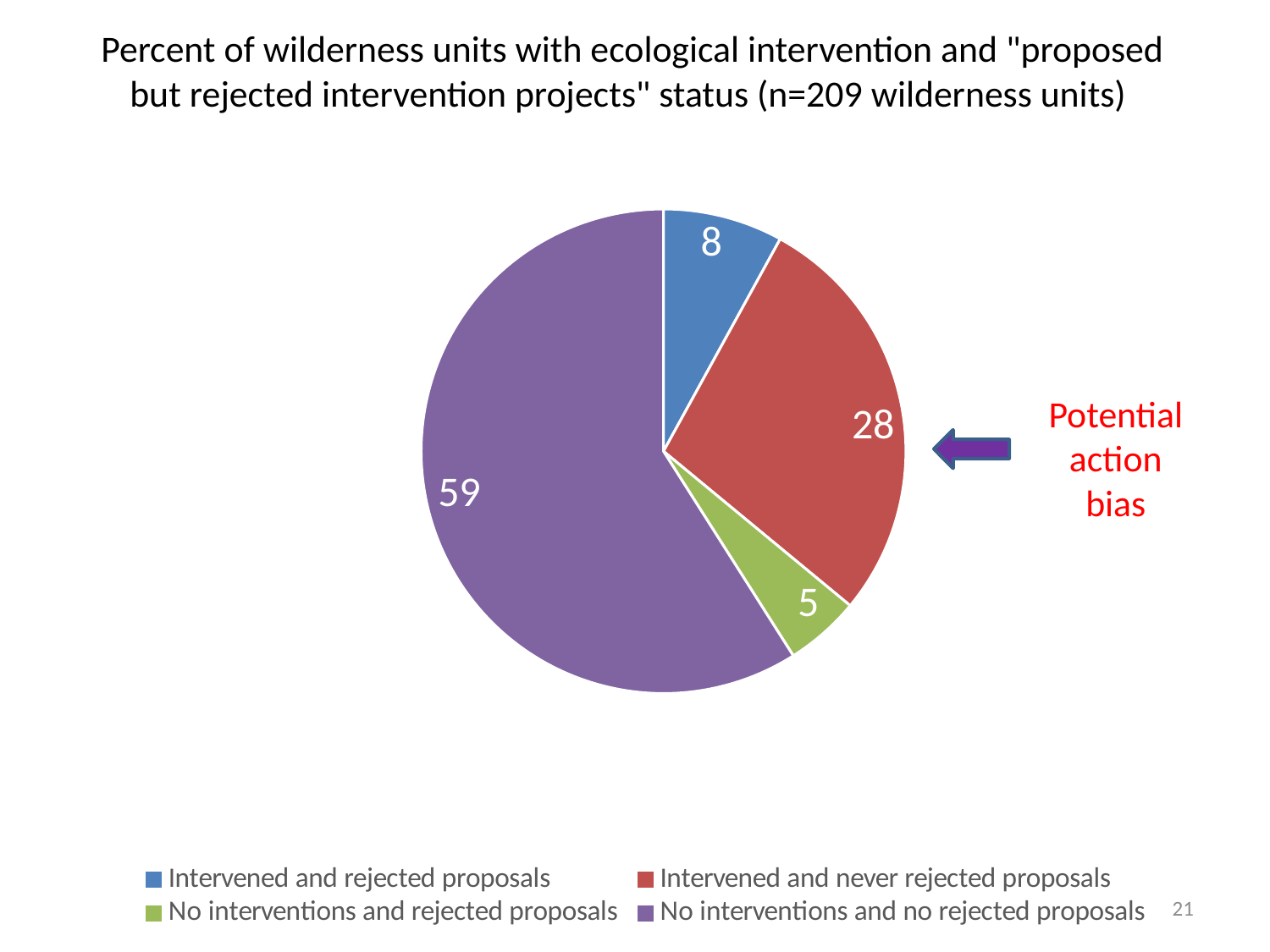
What colour is the slice for "Intervened and never rejected proposals"? red What is the difference between the values for "No interventions and no rejected proposals" and "Intervened and never rejected proposals"? 31 What is the value for "Intervened and rejected proposals"? 8 What is the value for "Intervened and never rejected proposals"? 28 Which category has the smallest slice of the pie? No interventions and rejected proposals What is the value for "No interventions and no rejected proposals"? 59 How many slices does the pie chart have? 4 Which is larger: "Intervened and rejected proposals" or "No interventions and rejected proposals"? Intervened and rejected proposals What is the value for "No interventions and rejected proposals"? 5 How many entries does the legend list? 4 What type of chart is shown on the slide? pie chart Which category has the largest slice of the pie? No interventions and no rejected proposals